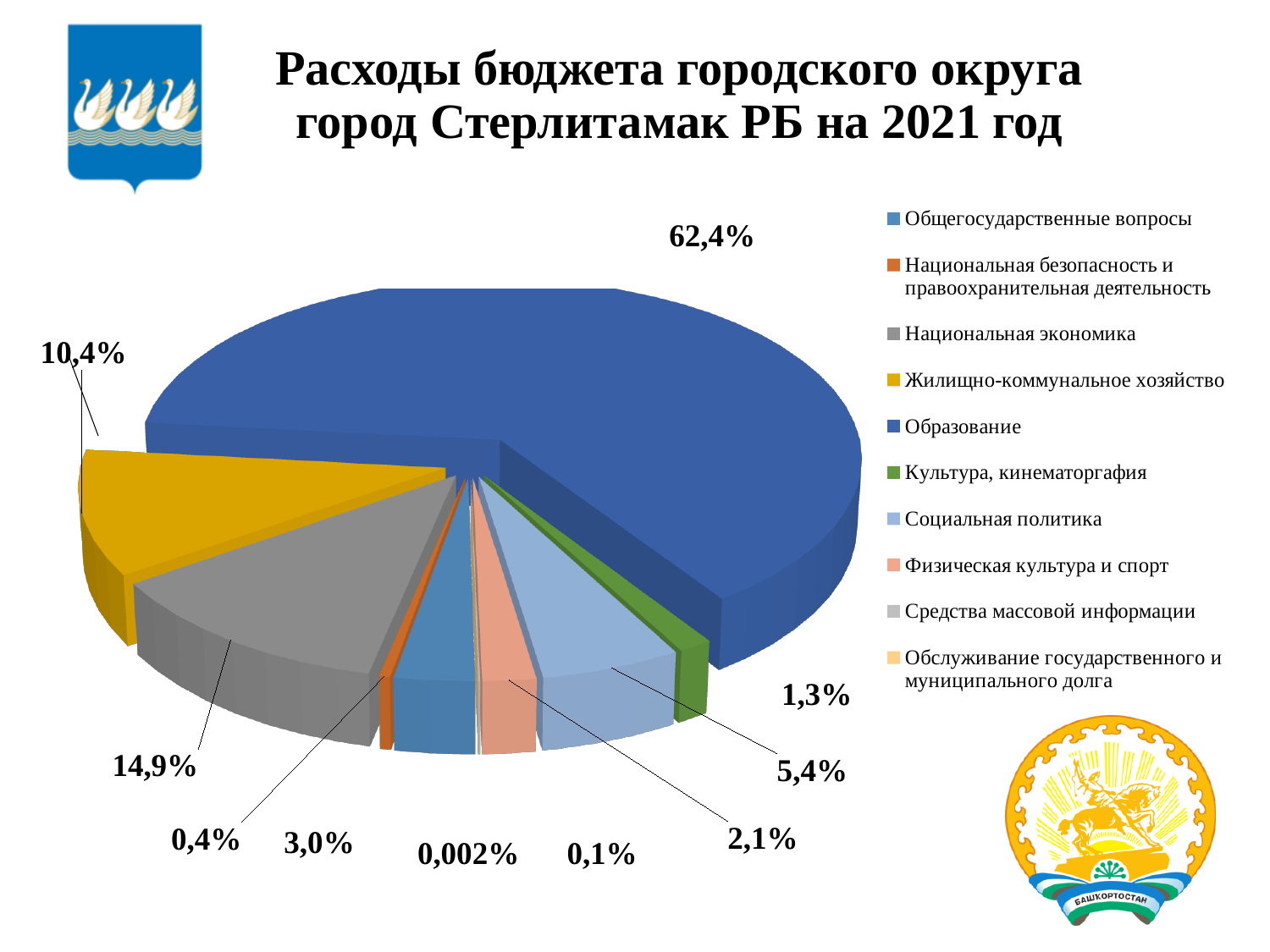
What share of the budget expenditure goes to Образование? 62,4% What is the title of the chart? Расходы бюджета городского округа город Стерлитамак РБ на 2021 год What share of the budget expenditure goes to Жилищно-коммунальное хозяйство? 10,4% What is the difference between the shares of Национальная экономика and Жилищно-коммунальное хозяйство? 4,5% How many categories does the legend list? 10 Which category has the smallest share of the budget expenditure? Обслуживание государственного и муниципального долга What share of the budget expenditure goes to Физическая культура и спорт? 2,1% What share of the budget expenditure goes to Социальная политика? 5,4% Which is larger: the share of Социальная политика or the share of Физическая культура и спорт? Социальная политика Which category has the largest share of the budget expenditure? Образование What share of the budget expenditure goes to Национальная экономика? 14,9% What kind of chart is shown on the slide? pie chart